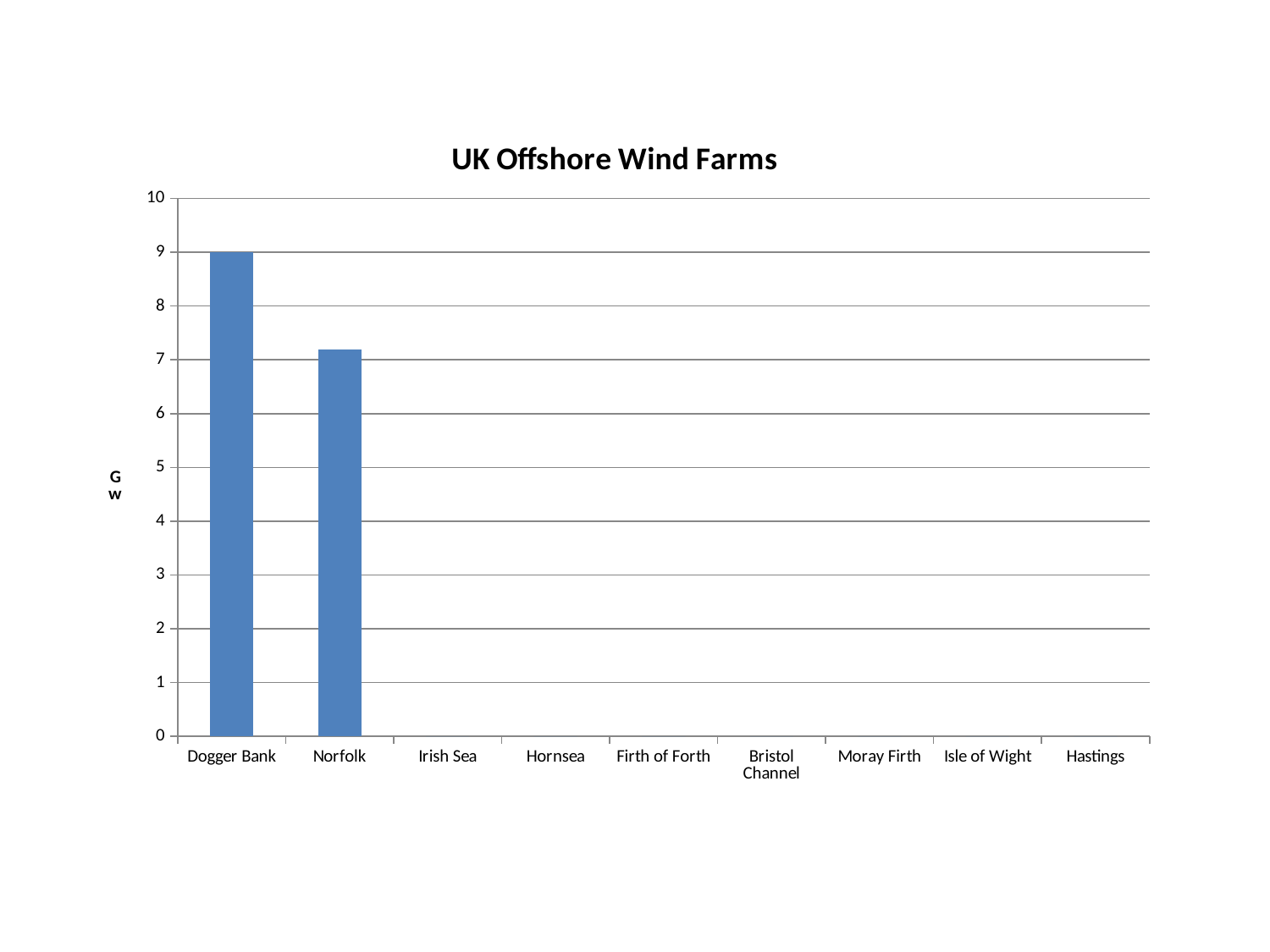
What kind of chart is shown on the slide? bar chart What is the label on the vertical axis of the chart? Gw Is the value for Norfolk greater or less than 8? less Which category has the highest value? Dogger Bank Is the value for Dogger Bank greater or less than 8? greater Is the value for Norfolk greater or less than 5? greater Which is larger, the value for Dogger Bank or the value for Norfolk? Dogger Bank What is the title of the chart? UK Offshore Wind Farms How many categories are listed along the x axis of the chart? 9 What is the value for Dogger Bank? 9